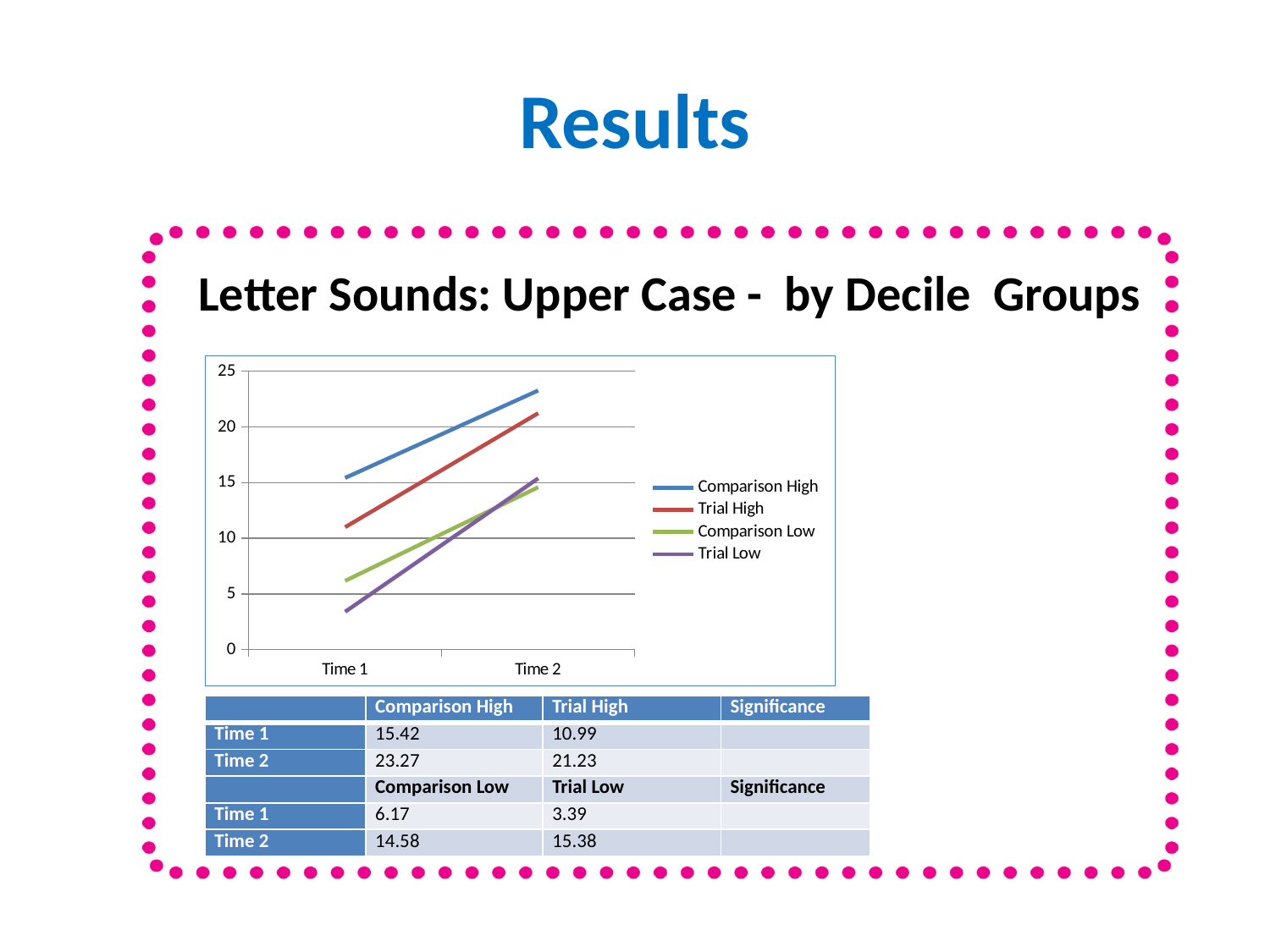
What kind of chart is shown on the slide? line chart Do the values for Trial High rise or fall from Time 1 to Time 2? rise How many time points are plotted along the x axis of the chart? 2 By how much does Comparison High increase from Time 1 to Time 2? 7.85 What is the title of the chart? Letter Sounds: Upper Case - by Decile Groups At Time 2, which is larger: Trial High or Comparison Low? Trial High Which series has the lowest value at Time 1? Trial Low How many series does the chart's legend list? 4 What is the value for Comparison High at Time 2? 23.27 Is the value for Trial High at Time 1 greater or less than 15? less Which series has the highest value at Time 2? Comparison High What is the value for Trial Low at Time 1? 3.39